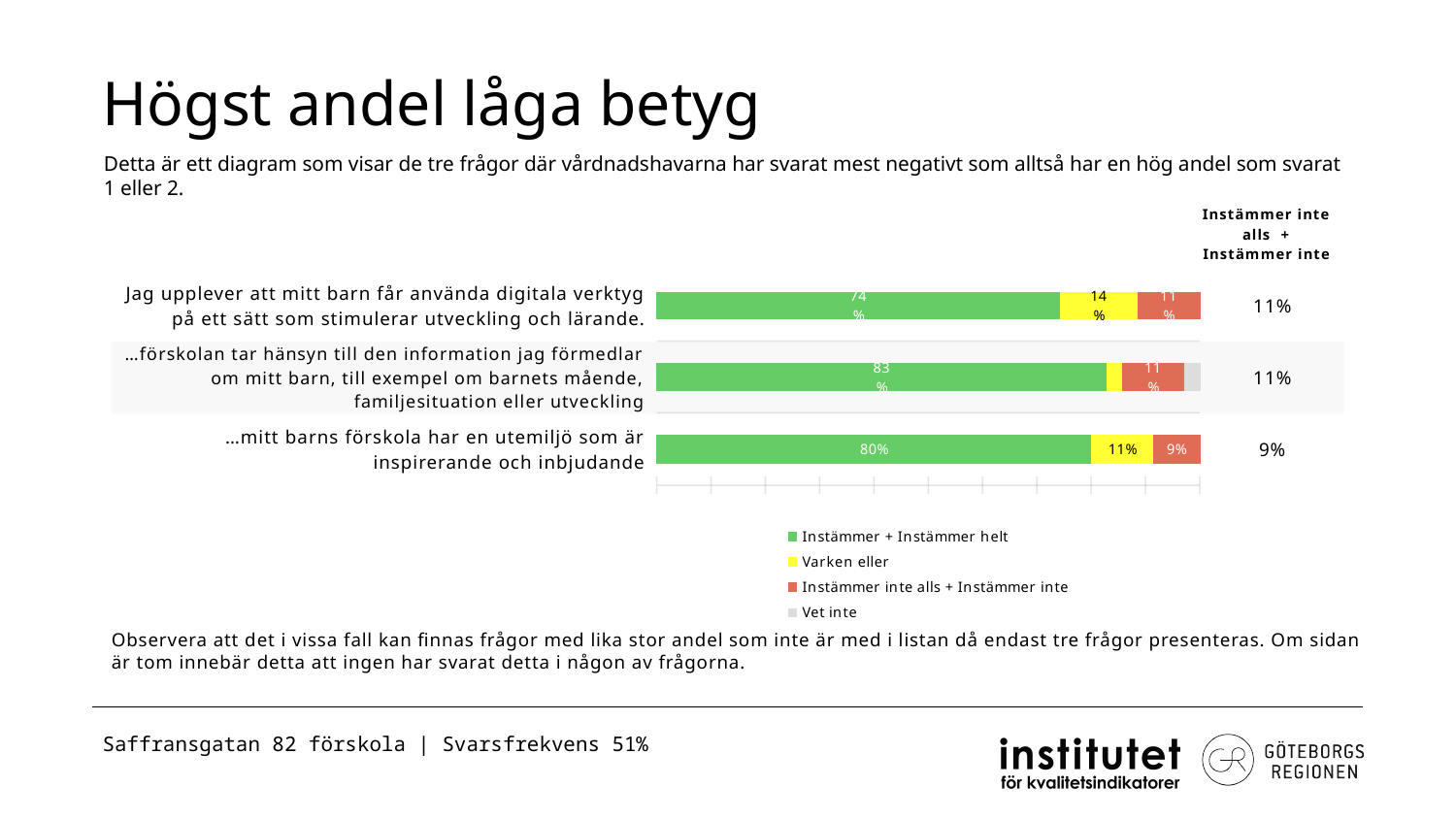
Which question has the lowest 'Instämmer inte alls + Instämmer inte' share? …mitt barns förskola har en utemiljö som är inspirerande och inbjudande What is the 'Varken eller' share for '…mitt barns förskola har en utemiljö som är inspirerande och inbjudande'? 11% What kind of chart is shown on the slide? Stacked bar chart Which has the larger 'Varken eller' share: 'Jag upplever att mitt barn får använda digitala verktyg' or '…mitt barns förskola har en utemiljö som är inspirerande och inbjudande'? Jag upplever att mitt barn får använda digitala verktyg How many series does the chart legend list? 4 Which question has the highest 'Instämmer + Instämmer helt' share? …förskolan tar hänsyn till den information jag förmedlar om mitt barn, till exempel om barnets mående, familjesituation eller utveckling What colour represents 'Vet inte' in the chart legend? Grey What is the 'Instämmer + Instämmer helt' share for '…förskolan tar hänsyn till den information jag förmedlar om mitt barn'? 83% What is the difference in 'Instämmer + Instämmer helt' share between '…förskolan tar hänsyn till den information jag förmedlar om mitt barn' and 'Jag upplever att mitt barn får använda digitala verktyg'? 9 percentage points What value is shown in the 'Instämmer inte alls + Instämmer inte' column for '…mitt barns förskola har en utemiljö som är inspirerande och inbjudande'? 9% What is the 'Instämmer + Instämmer helt' share for 'Jag upplever att mitt barn får använda digitala verktyg på ett sätt som stimulerar utveckling och lärande'? 74% How many questions (categories) are plotted in the chart? 3